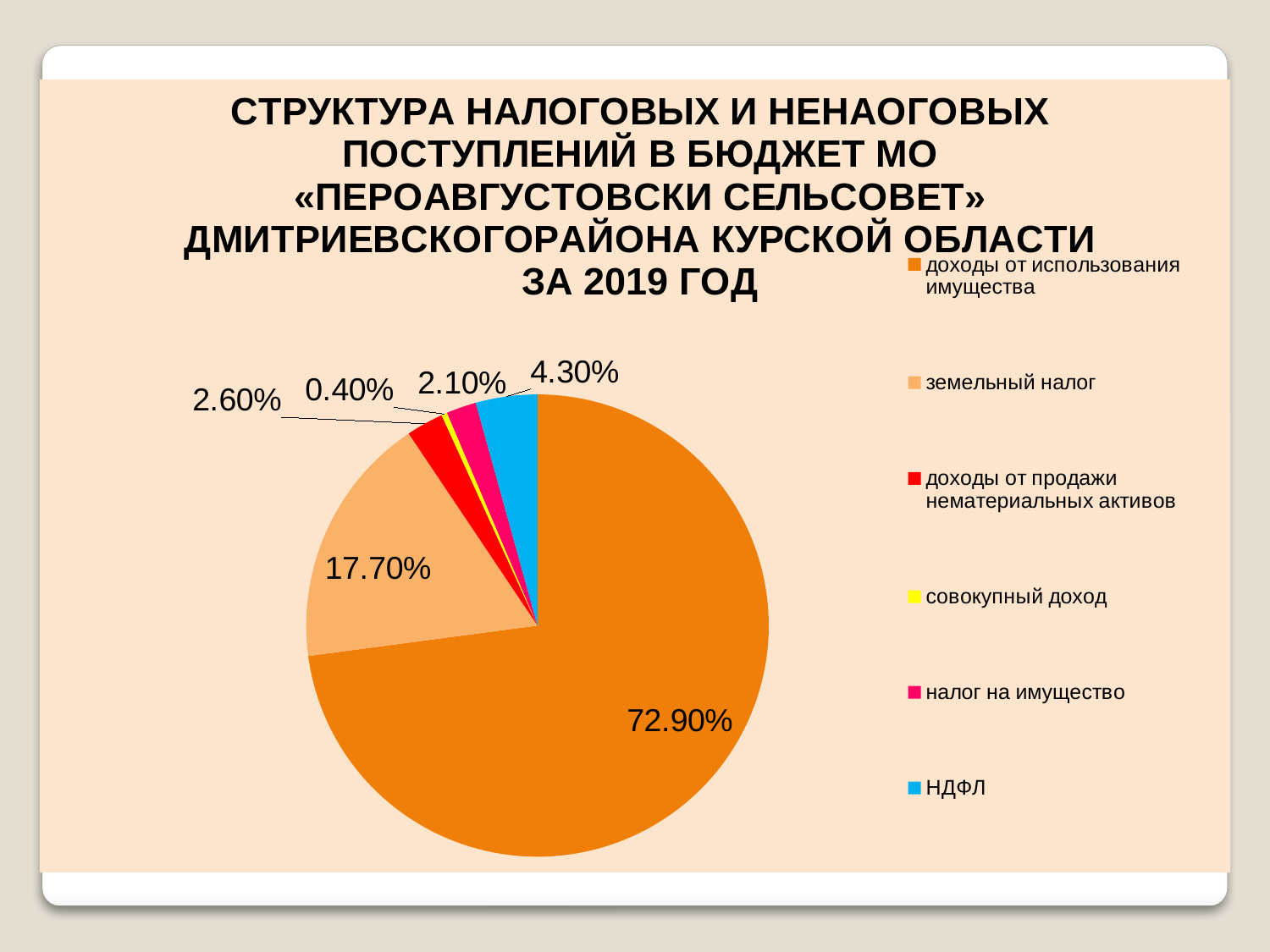
What colour is the slice for «НДФЛ»? blue What kind of chart is shown on the slide? pie chart How many slices does the pie chart have? 6 What share of the pie does «налог на имущество» have? 2.10% What share of the pie does «совокупный доход» have? 0.40% What is the difference between the shares of «земельный налог» and «НДФЛ»? 13.40% What share of the pie does «НДФЛ» have? 4.30% What share of the pie does «земельный налог» have? 17.70% Which is larger: the share of «доходы от продажи нематериальных активов» or the share of «налог на имущество»? доходы от продажи нематериальных активов Which category has the largest share of the pie? доходы от использования имущества What share of the pie does «доходы от использования имущества» have? 72.90% Which category has the smallest share of the pie? совокупный доход